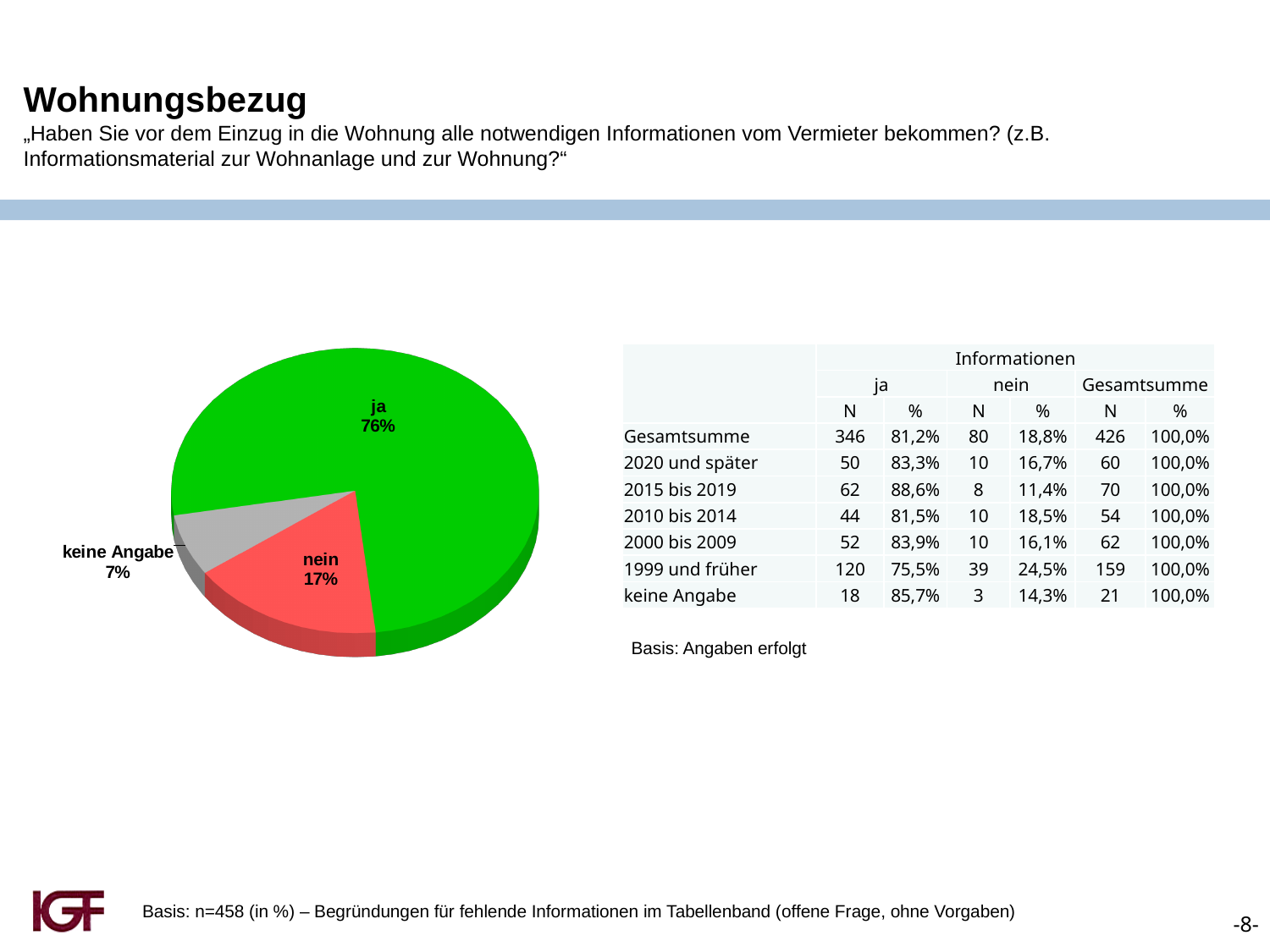
What percentage of the pie chart is labelled "keine Angabe"? 7% What percentage of the pie chart is labelled "ja"? 76% Which slice of the pie chart is the smallest? keine Angabe Which slice of the pie chart is larger, "nein" or "keine Angabe"? nein What type of chart is shown on the slide? pie chart What is the difference in percentage points between the "ja" and "nein" slices of the pie chart? 59 What percentage of the pie chart is labelled "nein"? 17% How many slices does the pie chart have? 3 Which slice of the pie chart is the largest? ja What is the difference in percentage points between the "nein" and "keine Angabe" slices of the pie chart? 10 What colour is the "ja" slice of the pie chart? green What colour is the "nein" slice of the pie chart? red